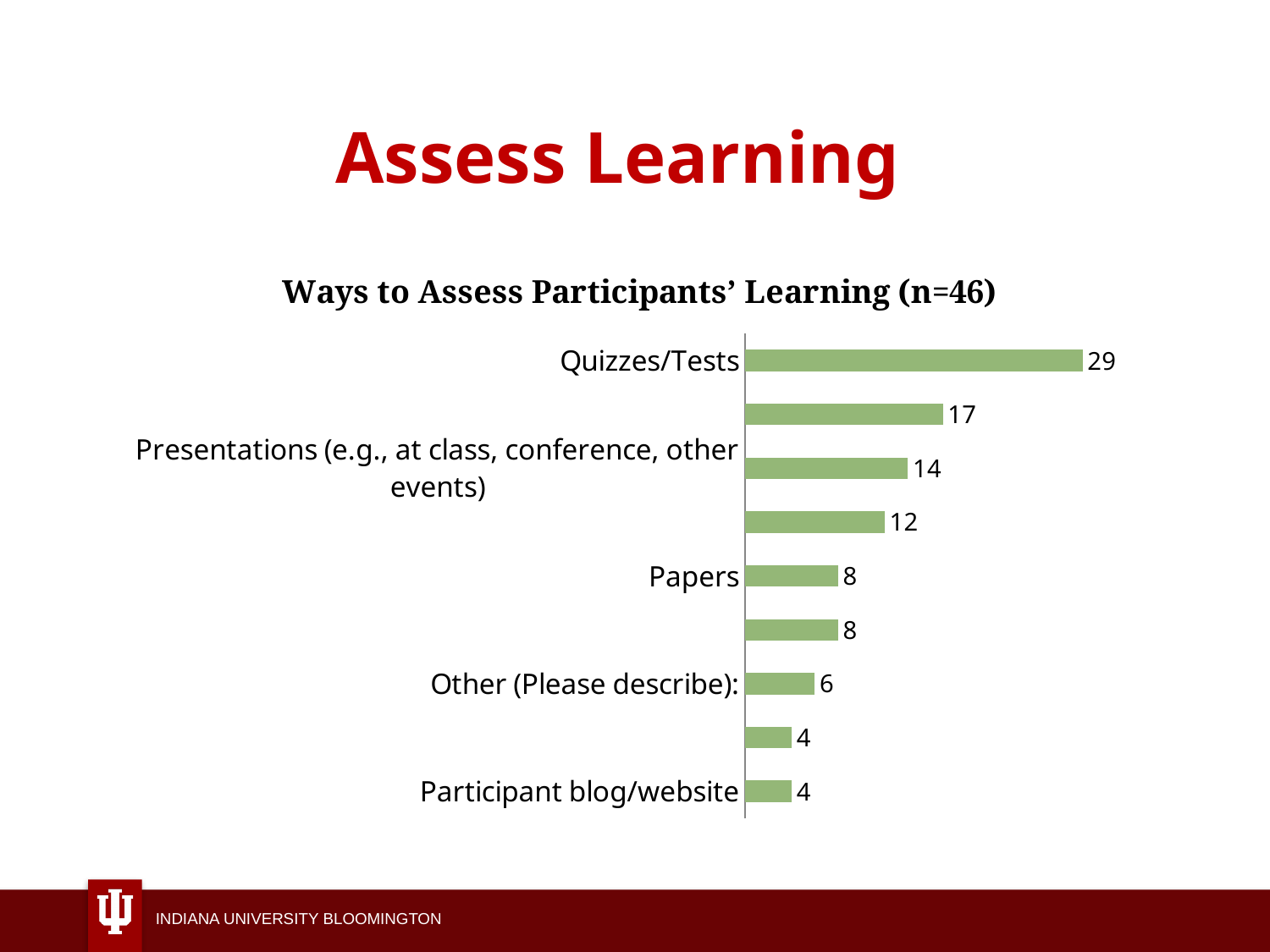
Which is larger, the value for Presentations or the value for Papers? Presentations Which category has the highest value? Quizzes/Tests What is the value for Presentations (e.g., at class, conference, other events)? 14 What type of chart is shown on the slide? bar chart What is the value for Quizzes/Tests? 29 What is the difference between the values for Papers and Participant blog/website? 4 What is the difference between the values for Quizzes/Tests and Papers? 21 What is the value for Participant blog/website? 4 What is the value for Other (Please describe):? 6 What is the title of the chart? Ways to Assess Participants' Learning (n=46) What is the value for Papers? 8 How many bars are plotted in the chart? 9